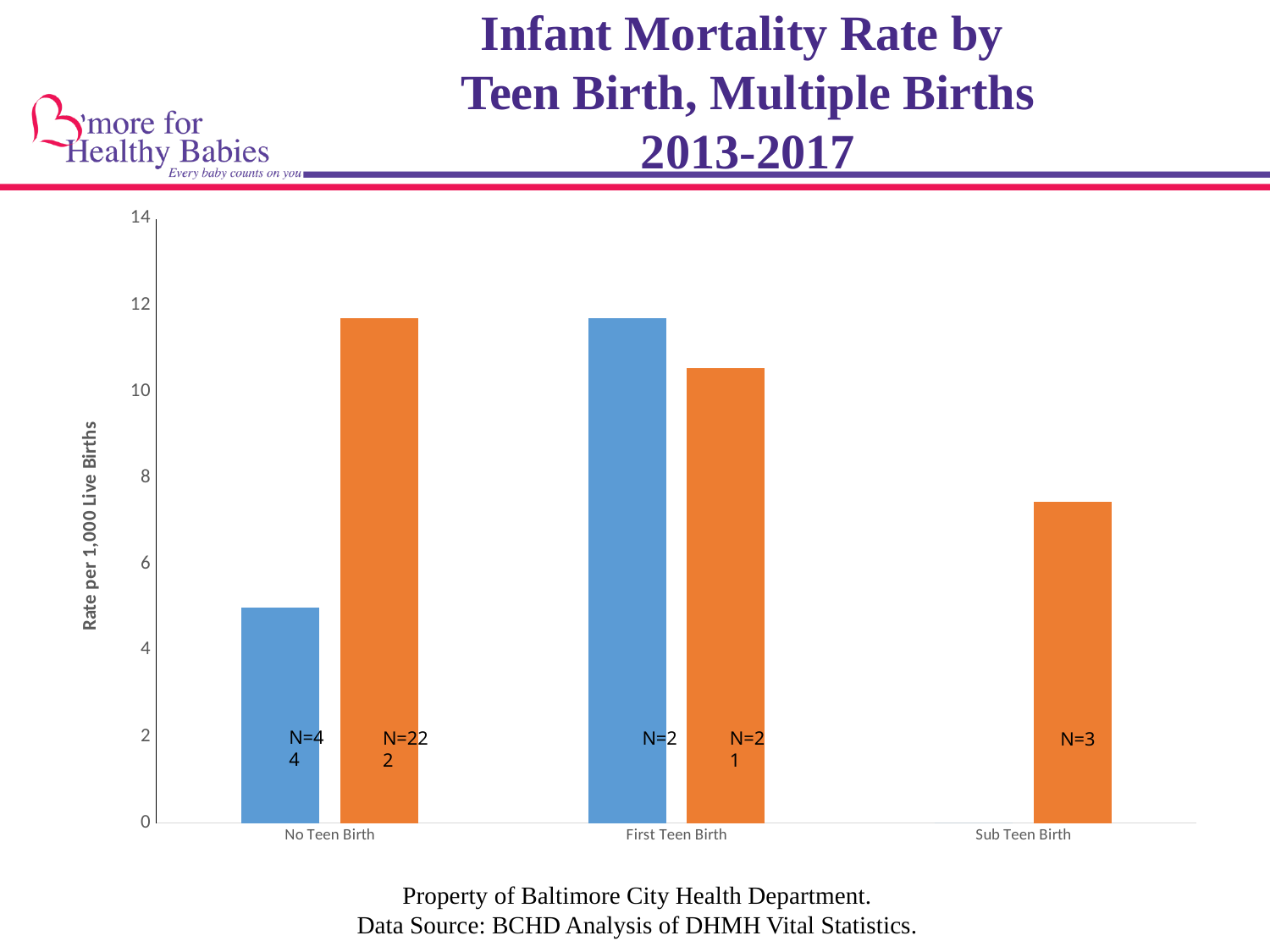
For First Teen Birth, which bar is larger, the blue bar or the orange bar? the blue bar Is the value of the orange bar for Sub Teen Birth greater or less than 8? less Is the value of the blue bar for No Teen Birth greater or less than 6? less Which bar on the chart is the lowest? the blue bar for No Teen Birth Is the value of the blue bar for First Teen Birth greater or less than 10? greater What kind of chart is shown on the slide? bar chart What N value is printed on the orange bar for No Teen Birth? N=222 What is the label on the vertical axis? Rate per 1,000 Live Births For No Teen Birth, which bar is larger, the blue bar or the orange bar? the orange bar What is the title of the chart? Infant Mortality Rate by Teen Birth, Multiple Births 2013-2017 How many categories are shown on the x axis? 3